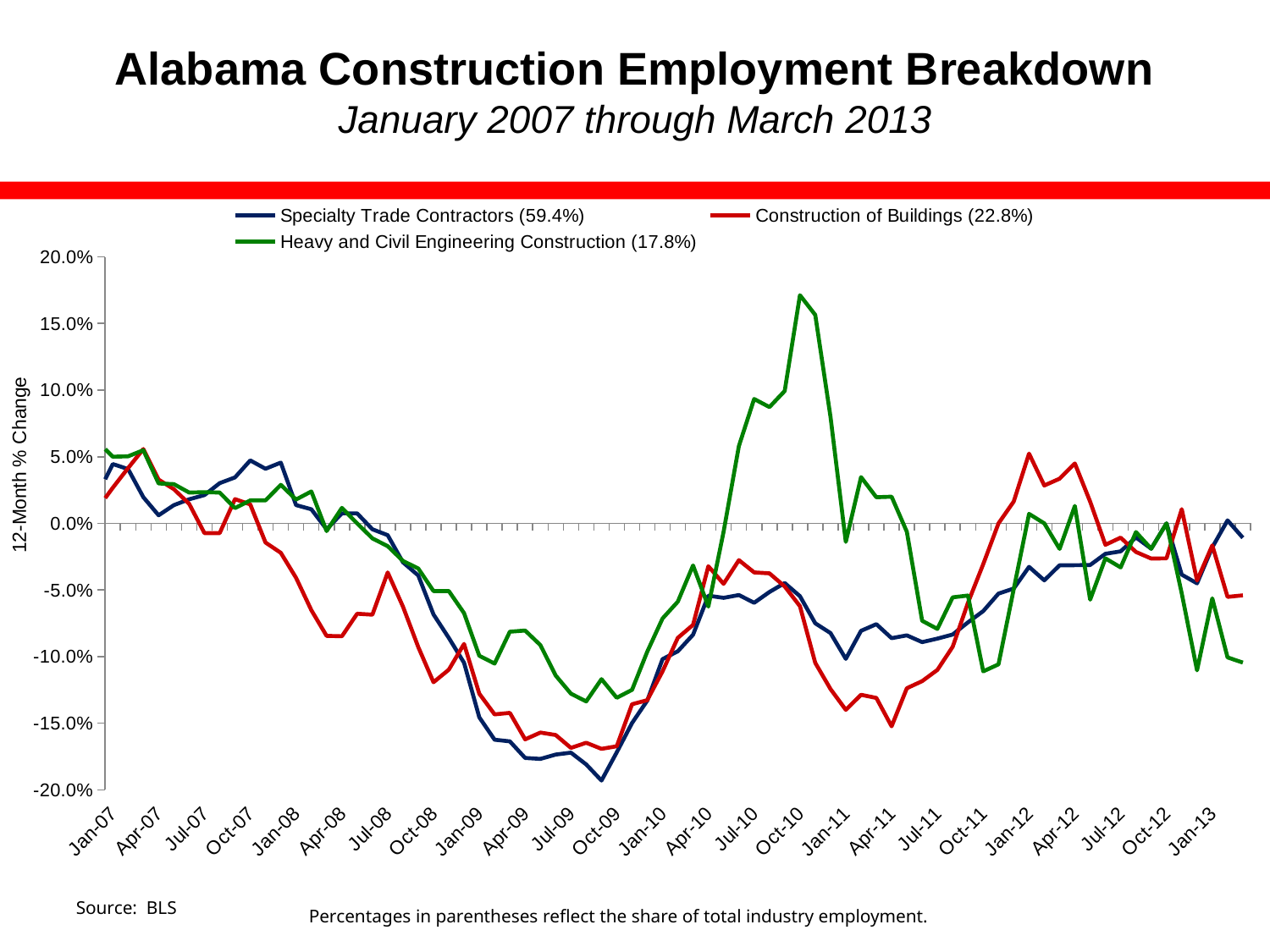
Which series reaches the highest value anywhere on the chart? Heavy and Civil Engineering Construction According to the legend, what share of total industry employment do Specialty Trade Contractors represent? 59.4% Does the Specialty Trade Contractors line rise or fall between Jan-07 and Oct-09? fall How many series does the legend list? 3 Which series reaches the lowest value anywhere on the chart? Specialty Trade Contractors At Oct-10, which series has the higher value: Heavy and Civil Engineering Construction or Specialty Trade Contractors? Heavy and Civil Engineering Construction Is the value for Construction of Buildings at Jan-12 greater or less than 0.0%? greater Is the value for Specialty Trade Contractors around Oct-09 greater or less than -15.0%? less What kind of chart is shown on the slide? line chart Is the peak value for Heavy and Civil Engineering Construction around Oct-10 greater or less than 15.0%? greater What is the label on the vertical axis? 12-Month % Change